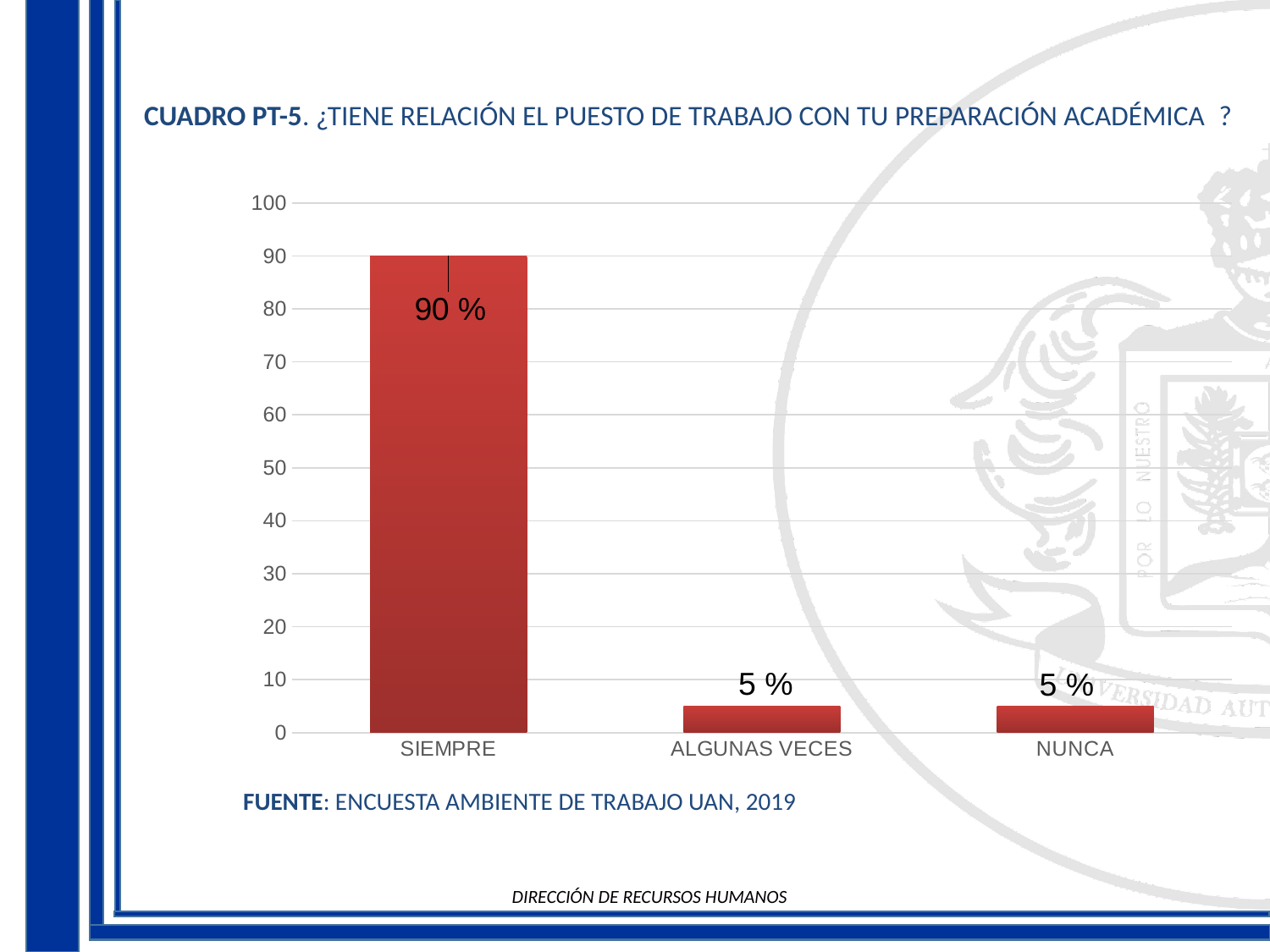
What is the value for SIEMPRE? 90 % What is the highest value shown on the y axis? 100 How many categories are shown on the x axis? 3 What is the difference between the values for SIEMPRE and ALGUNAS VECES? 85 % What kind of chart is shown on the slide? bar chart Is the value for NUNCA greater or less than 10? less Which category has the highest value? SIEMPRE What is the value for ALGUNAS VECES? 5 % Is the value for SIEMPRE greater or less than 50? greater What is the value for NUNCA? 5 % What is the source cited below the chart? ENCUESTA AMBIENTE DE TRABAJO UAN, 2019 Which is larger, the value for SIEMPRE or the value for NUNCA? SIEMPRE